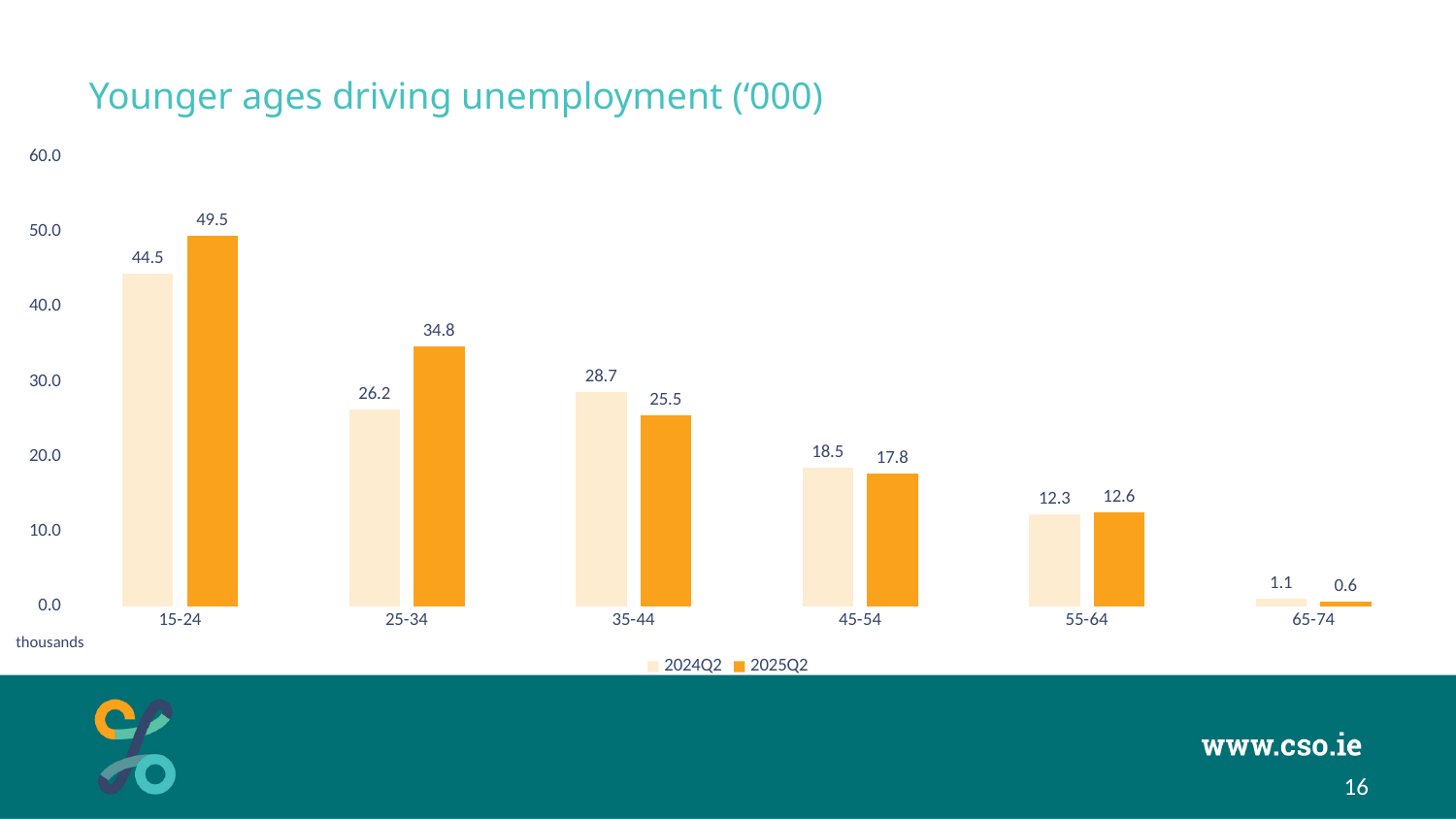
Which age group has the lowest value in 2024Q2? 65-74 What is the value for the 15-24 age group in 2025Q2? 49.5 For the 35-44 age group, which is larger: the 2024Q2 value or the 2025Q2 value? 2024Q2 What is the difference between the 2025Q2 and 2024Q2 values for the 25-34 age group? 8.6 How many age groups are shown on the x axis? 6 What kind of chart is shown on the slide? bar chart Is the 2024Q2 value for the 45-54 age group greater or less than 20.0? less What is the title of the chart? Younger ages driving unemployment ('000) Which age group has the highest value in 2025Q2? 15-24 What is the value for the 65-74 age group in 2025Q2? 0.6 What is the value for the 35-44 age group in 2024Q2? 28.7 How many series does the legend list? 2